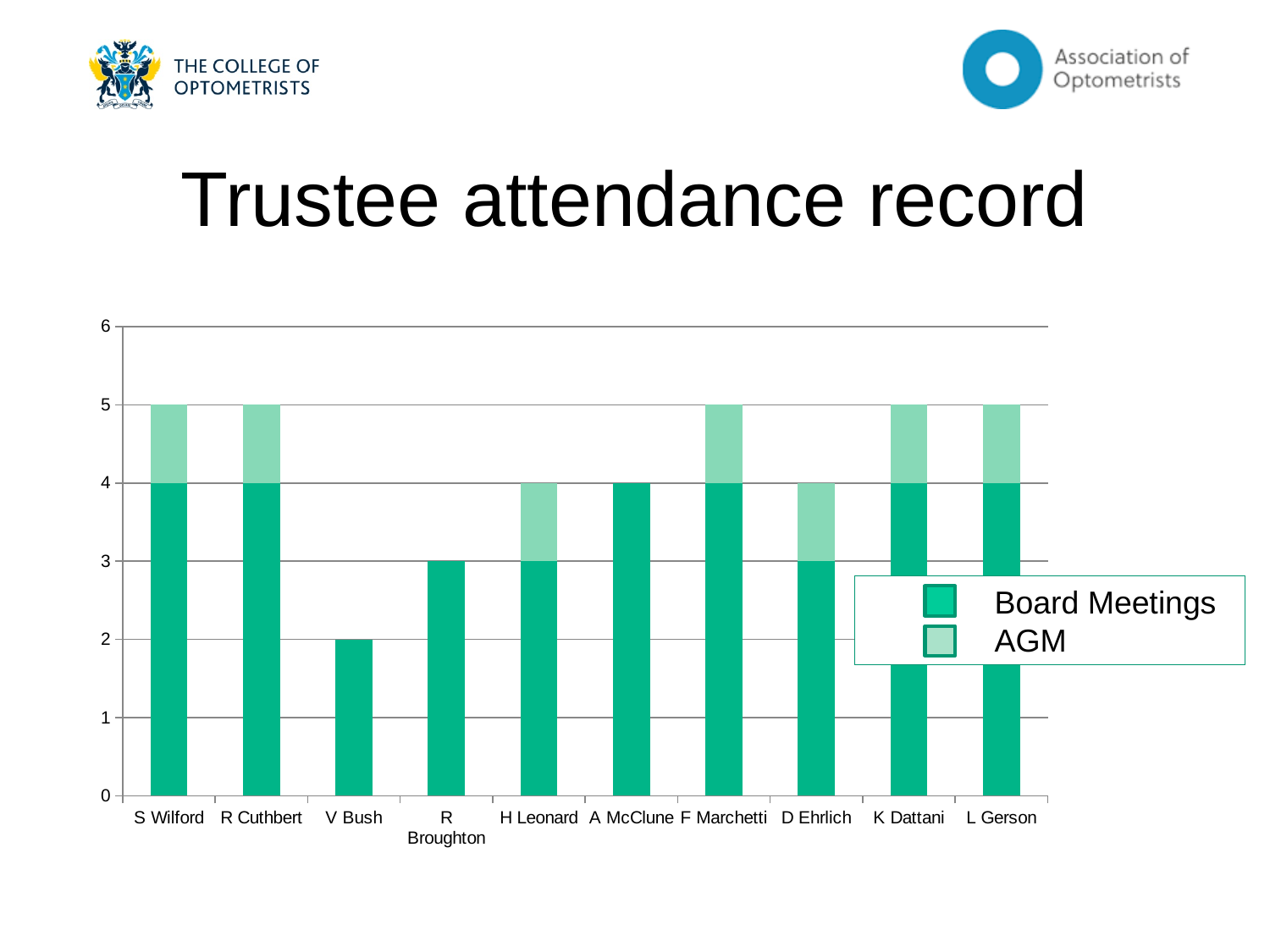
How many Board Meetings did V Bush attend? 2 How many Board Meetings did R Broughton attend? 3 How many series does the legend list? 2 What are the two series named in the legend? Board Meetings and AGM Is the total bar for V Bush greater or less than 3? less Which trustee has the lowest Board Meetings attendance? V Bush Who attended more Board Meetings, A McClune or H Leonard? A McClune What is the total height of the stacked bar for D Ehrlich? 4 What is the total height of the stacked bar for S Wilford? 5 How many trustees are listed along the x axis of the chart? 10 What is the difference between the Board Meetings attendance of K Dattani and V Bush? 2 What kind of chart is shown on the slide? Stacked bar chart